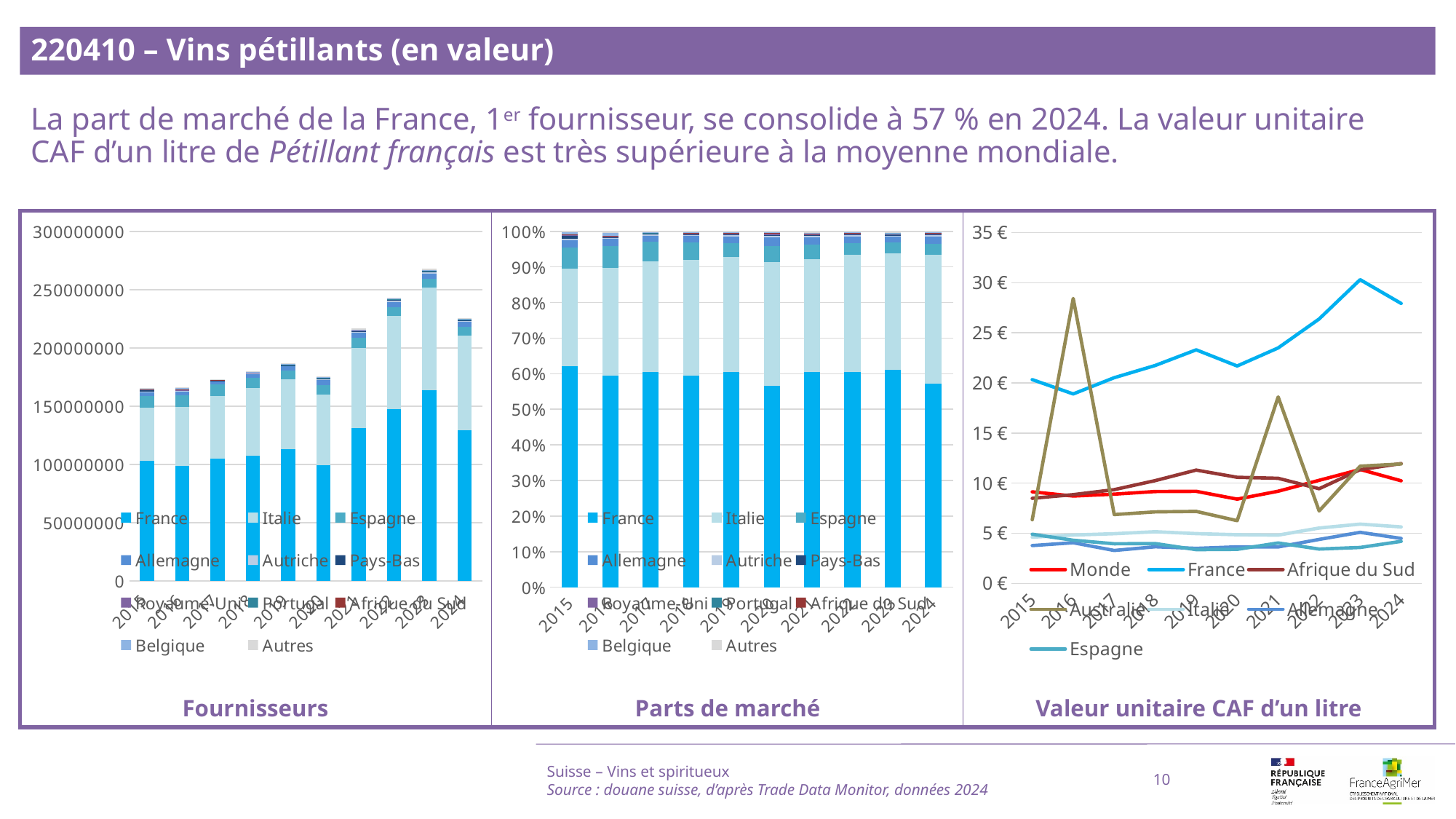
How many years are shown on the x axis of the 'Parts de marché' chart? 10 What kind of chart is the 'Valeur unitaire CAF d'un litre' chart? line chart In the 'Fournisseurs' chart, is the total for 2023 greater or less than 250000000? greater How many series does the legend of the 'Valeur unitaire CAF d'un litre' chart list? 7 How many series does the legend of the 'Fournisseurs' chart list? 11 In the 'Valeur unitaire CAF d'un litre' chart, is the value for Australie in 2016 greater or less than 25 €? greater What kind of chart is the 'Fournisseurs' chart? stacked bar chart In the 'Valeur unitaire CAF d'un litre' chart, is the value for Monde in 2024 greater or less than 15 €? less In the 'Valeur unitaire CAF d'un litre' chart, which series has the highest value in 2024? France In the 'Fournisseurs' chart, which year has the highest total bar? 2023 In the 'Valeur unitaire CAF d'un litre' chart, does the France line rise or fall between 2020 and 2023? rise